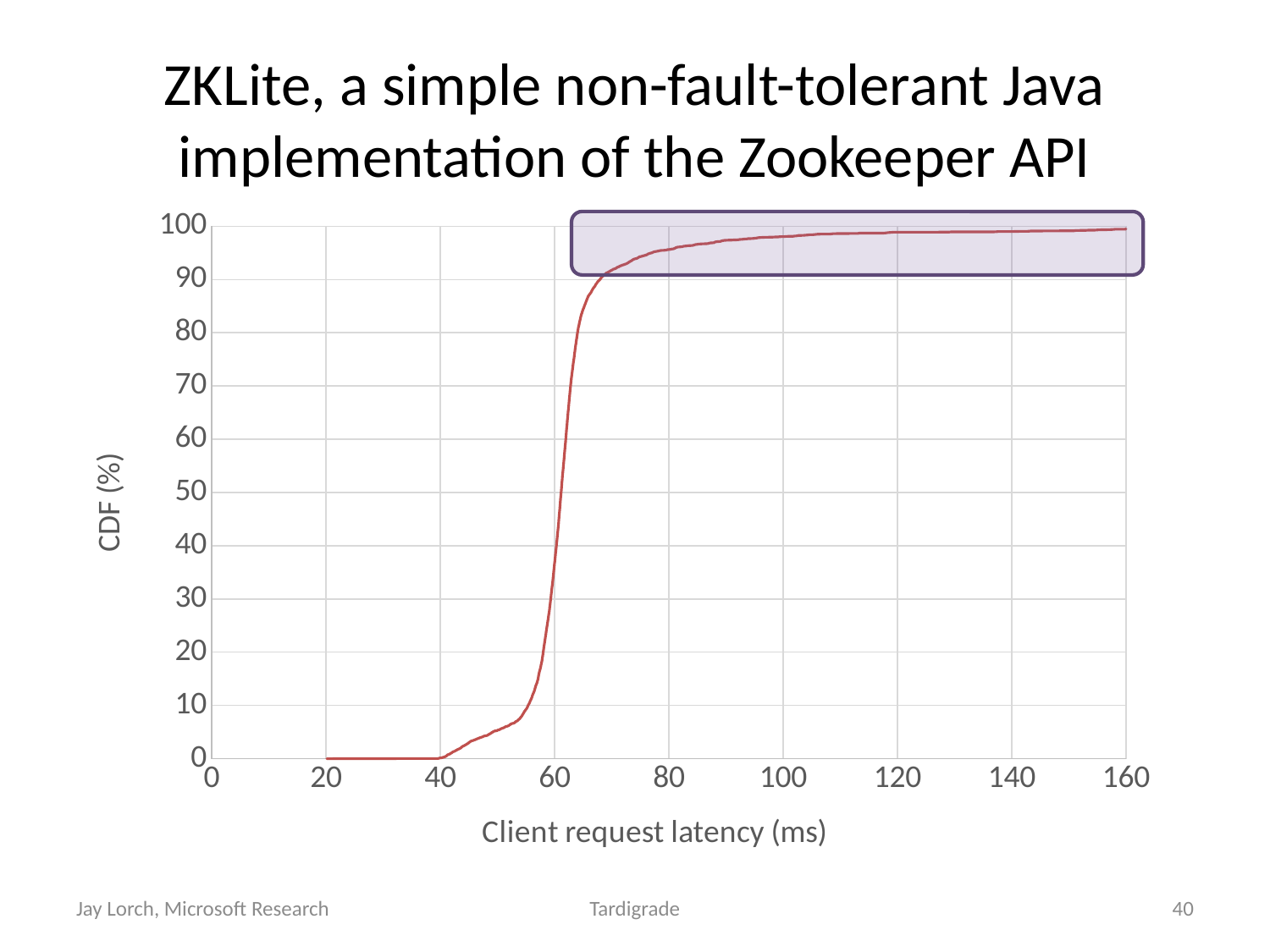
Is the CDF value at a client request latency of 80 ms greater or less than 90? greater Is the CDF value at a client request latency of 30 ms greater or less than 10? less What is the highest tick value shown on the x axis? 160 Is the CDF value at a client request latency of 100 ms greater or less than 90? greater What is the label of the x axis? Client request latency (ms) What is the label of the y axis? CDF (%) What kind of chart is shown on the slide? line chart Does the CDF curve rise or fall as client request latency increases along the x axis? rise How many lines are plotted on the chart? 1